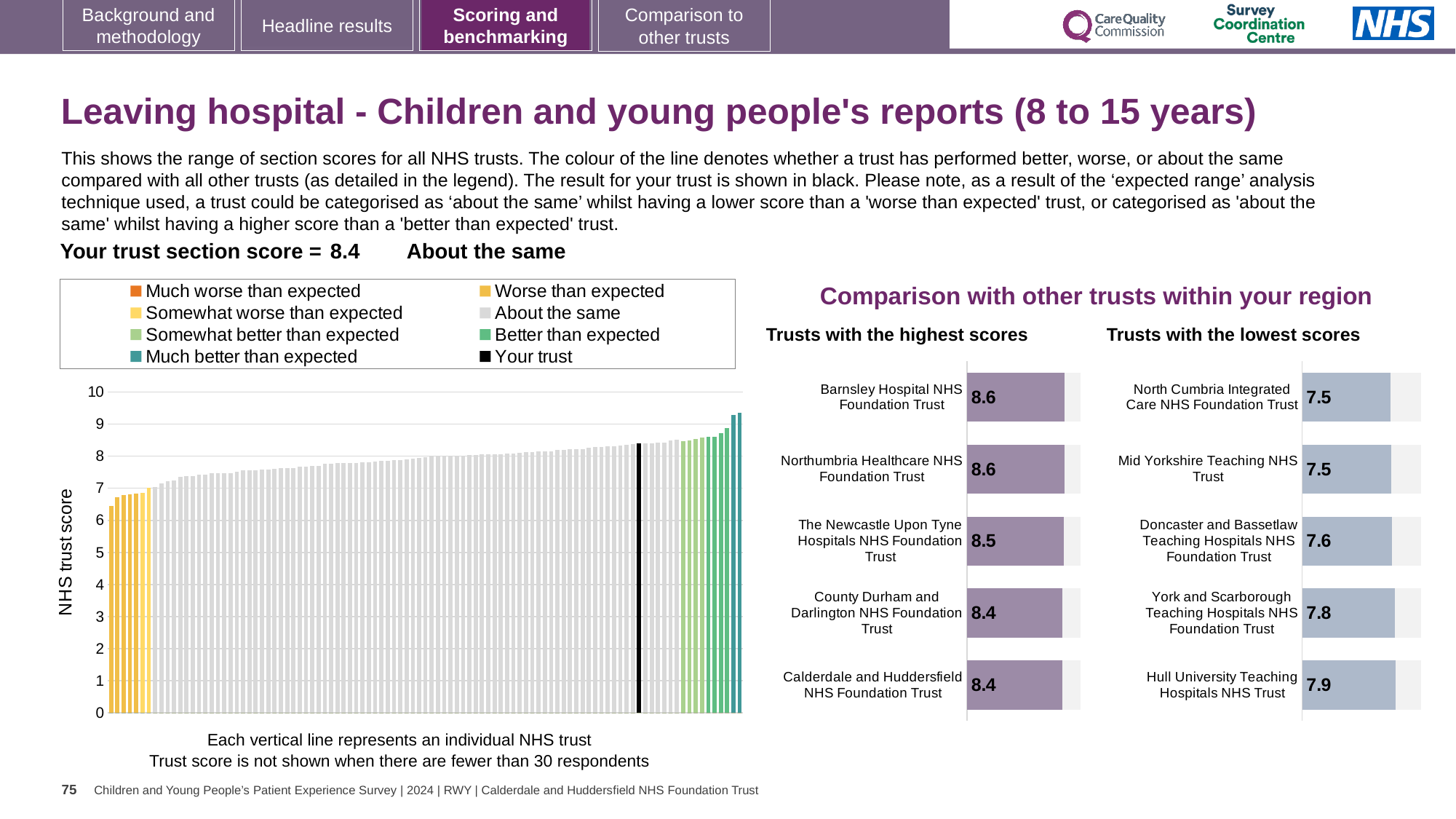
In the 'Trusts with the highest scores' chart, what is the score for The Newcastle Upon Tyne Hospitals NHS Foundation Trust? 8.5 What kind of chart is the large chart on the left showing NHS trust scores? Bar chart In the 'Trusts with the lowest scores' chart, what is the score for Hull University Teaching Hospitals NHS Trust? 7.9 What is the label on the vertical axis of the large chart on the left? NHS trust score How many entries does the legend of the large chart on the left list? 8 In the 'Trusts with the lowest scores' chart, how much higher is Hull University Teaching Hospitals NHS Trust's score than North Cumbria Integrated Care NHS Foundation Trust's? 0.4 In the 'Trusts with the lowest scores' chart, which has the larger score: Doncaster and Bassetlaw Teaching Hospitals NHS Foundation Trust or York and Scarborough Teaching Hospitals NHS Foundation Trust? York and Scarborough Teaching Hospitals NHS Foundation Trust In the 'Trusts with the highest scores' chart, what is the difference between the scores of Barnsley Hospital NHS Foundation Trust and Calderdale and Huddersfield NHS Foundation Trust? 0.2 In the large chart on the left, what is the section score for your trust, shown by the black bar? 8.4 How many trusts are listed in the 'Trusts with the highest scores' chart? 5 In the 'Trusts with the lowest scores' chart, which trust has the highest score? Hull University Teaching Hospitals NHS Trust In the large chart on the left, do the trust scores rise or fall from left to right? Rise